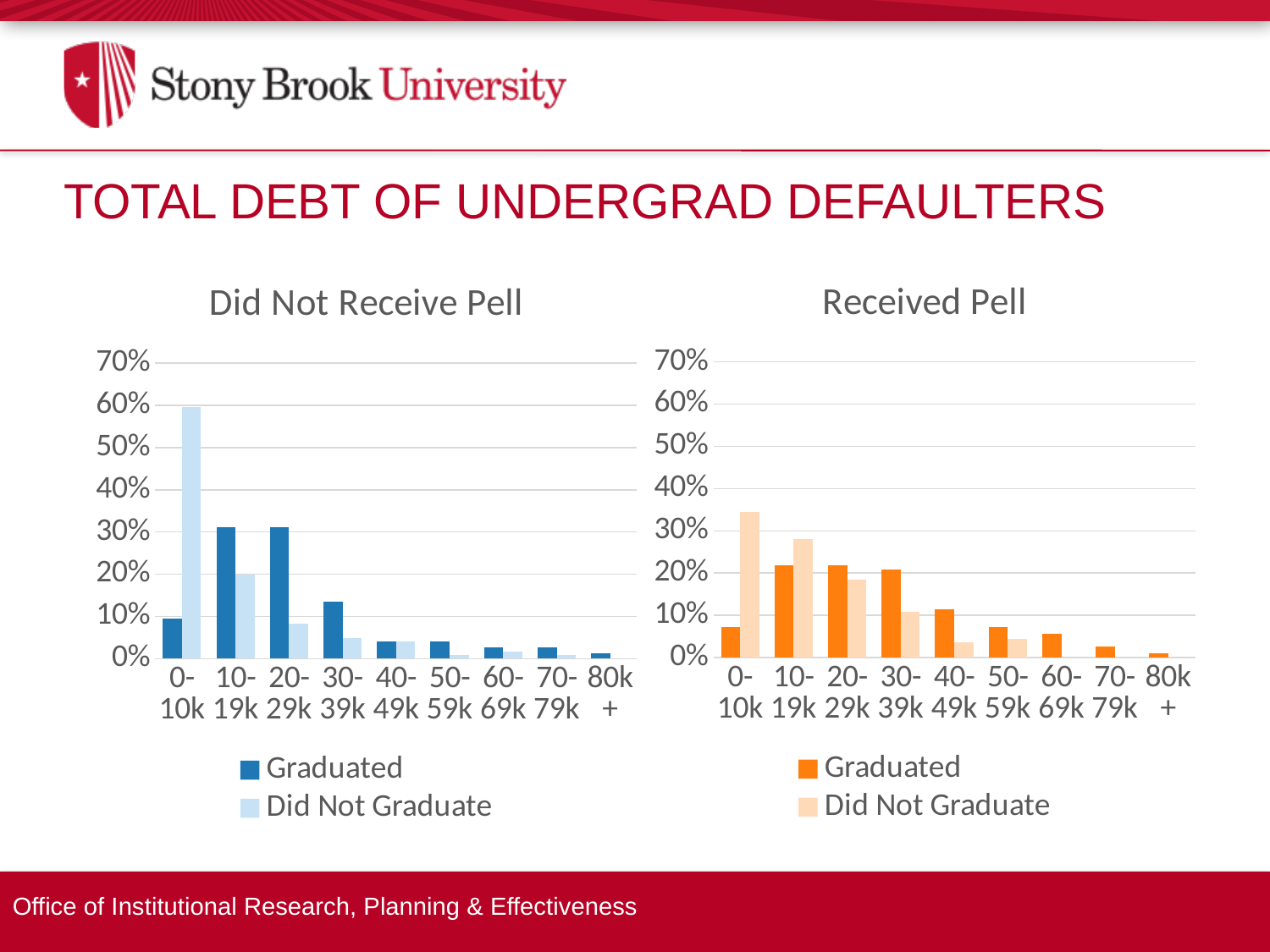
In the 'Did Not Receive Pell' chart, which is larger for the 20-29k category: Graduated or Did Not Graduate? Graduated In the 'Received Pell' chart, which is larger for the 30-39k category: Graduated or Did Not Graduate? Graduated In the 'Did Not Receive Pell' chart, which debt category has the highest Did Not Graduate value? 0-10k How many debt categories are shown on the x axis of the 'Did Not Receive Pell' chart? 9 In the 'Did Not Receive Pell' chart, which is larger for the 0-10k category: Graduated or Did Not Graduate? Did Not Graduate In the 'Received Pell' chart, which debt category has the highest Did Not Graduate value? 0-10k In the 'Received Pell' chart, do the Did Not Graduate values rise or fall from 0-10k to 40-49k? fall In the 'Did Not Receive Pell' chart, is the Graduated value for 10-19k greater or less than 20%? greater In the 'Received Pell' chart, is the Did Not Graduate value for 0-10k greater or less than 30%? greater In the 'Did Not Receive Pell' chart, is the Did Not Graduate value for 0-10k greater or less than 50%? greater How many series does the legend of the 'Received Pell' chart list? 2